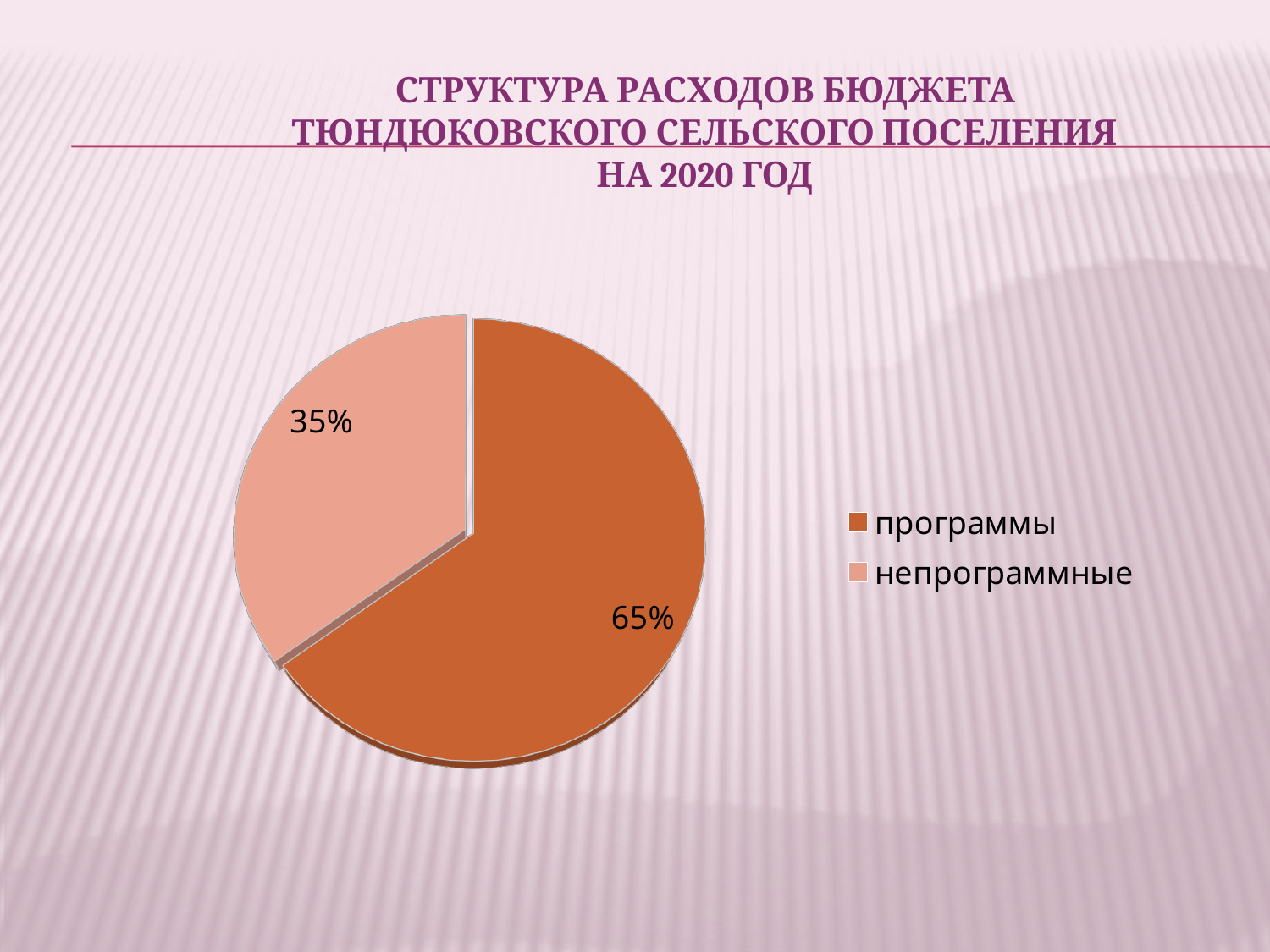
How many slices does the pie chart have? 2 How many entries does the legend list? 2 What share of the pie does the "программы" slice represent? 65% What kind of chart is shown on the slide? pie chart Which slice of the pie is the largest? программы What is the difference in percentage points between the "программы" and "непрограммные" slices? 30% What colour is the "непрограммные" slice? light pink/salmon What year does the slide title say the budget expenditure structure is for? 2020 What share of the pie does the "непрограммные" slice represent? 35% Which slice of the pie is the smallest? непрограммные Which is larger, the "программы" slice or the "непрограммные" slice? программы